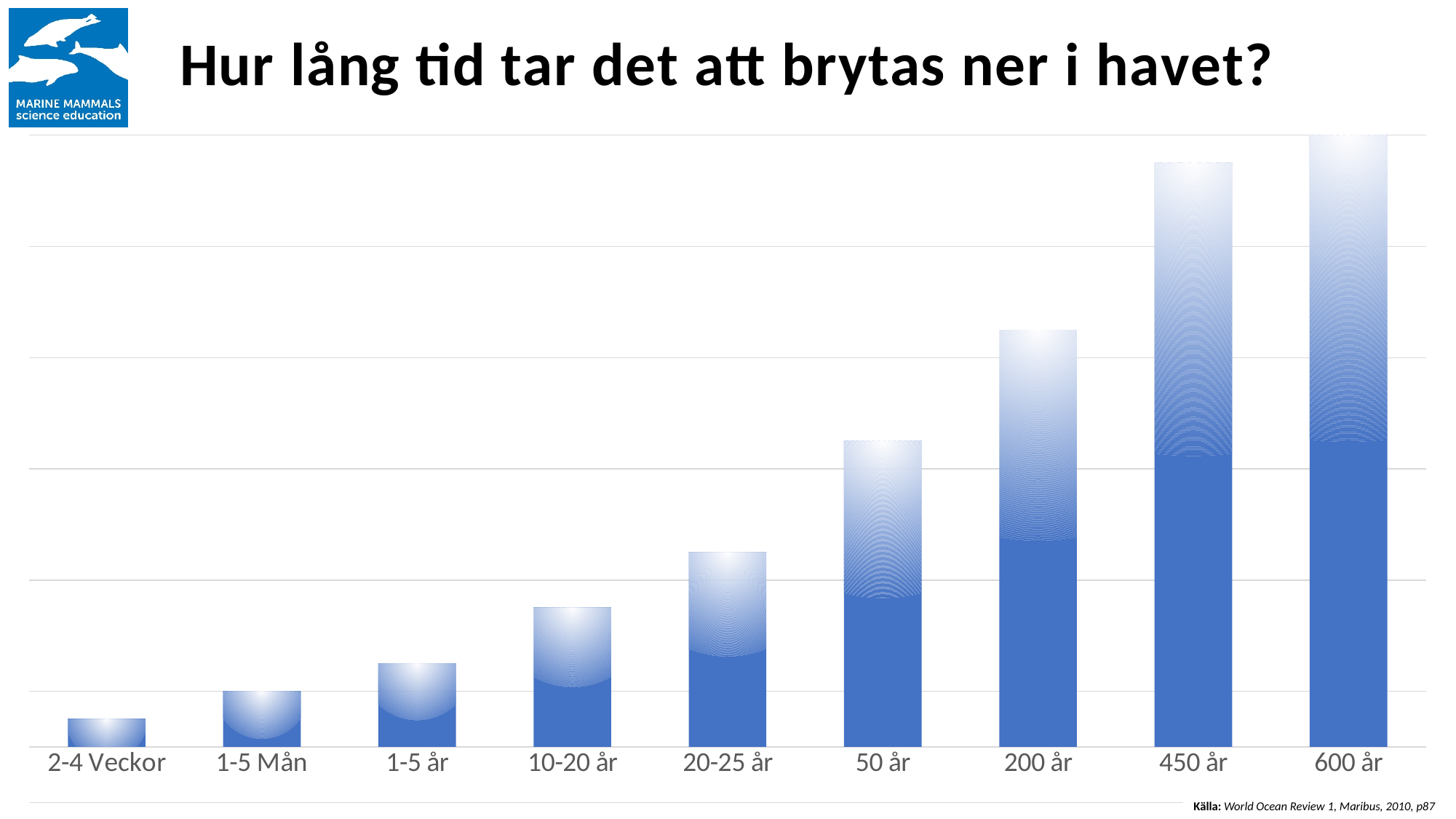
What is the title of the chart on the slide? Hur lång tid tar det att brytas ner i havet? Which category has the shortest bar? 2-4 Veckor Do the bar heights rise or fall from left to right along the x axis? rise Which bar is taller: 200 år or 450 år? 450 år What is the label of the first category on the x axis? 2-4 Veckor Which bar is taller: 1-5 Mån or 1-5 år? 1-5 år How many bars (categories) does the chart show? 9 Which category has the tallest bar? 600 år Which bar is shorter: 50 år or 20-25 år? 20-25 år What kind of chart is shown on the slide? bar chart